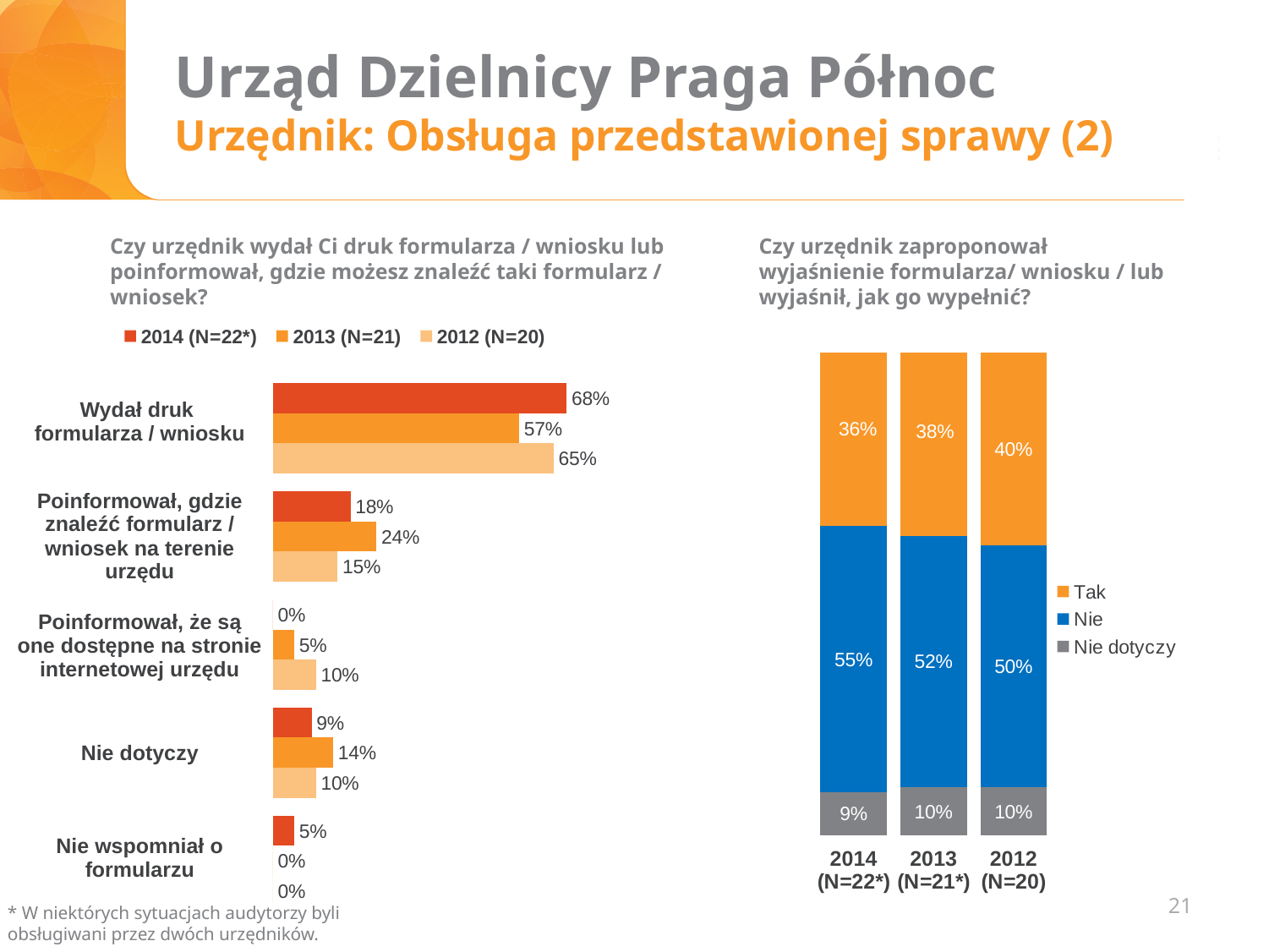
In the left chart, what is the 2012 (N=20) value for "Poinformował, że są one dostępne na stronie internetowej urzędu"? 10% In the right chart, does the "Tak" share rise or fall going from 2014 to 2012 along the x axis? Rises In the left chart, what is the 2013 (N=21) value for "Poinformował, gdzie znaleźć formularz / wniosek na terenie urzędu"? 24% In the left chart, which category has the highest value for 2014 (N=22*)? Wydał druk formularza / wniosku In the right chart, what is the total of the stacked bar for 2014 (N=22*)? 100% In the left chart ("Czy urzędnik wydał Ci druk formularza / wniosku..."), what is the value for "Wydał druk formularza / wniosku" in 2014 (N=22*)? 68% In the left chart, what is the difference between the 2014 and 2013 values for "Wydał druk formularza / wniosku"? 11% How many series does the legend of the left chart list? 3 In the left chart, which is larger for "Nie dotyczy": the 2013 (N=21) value or the 2014 (N=22*) value? 2013 (N=21) How many categories are shown in the left chart? 5 What kind of chart is the right chart ("Czy urzędnik zaproponował wyjaśnienie formularza...")? Stacked bar chart In the right chart, what is the "Nie" value for 2013 (N=21*)? 52%